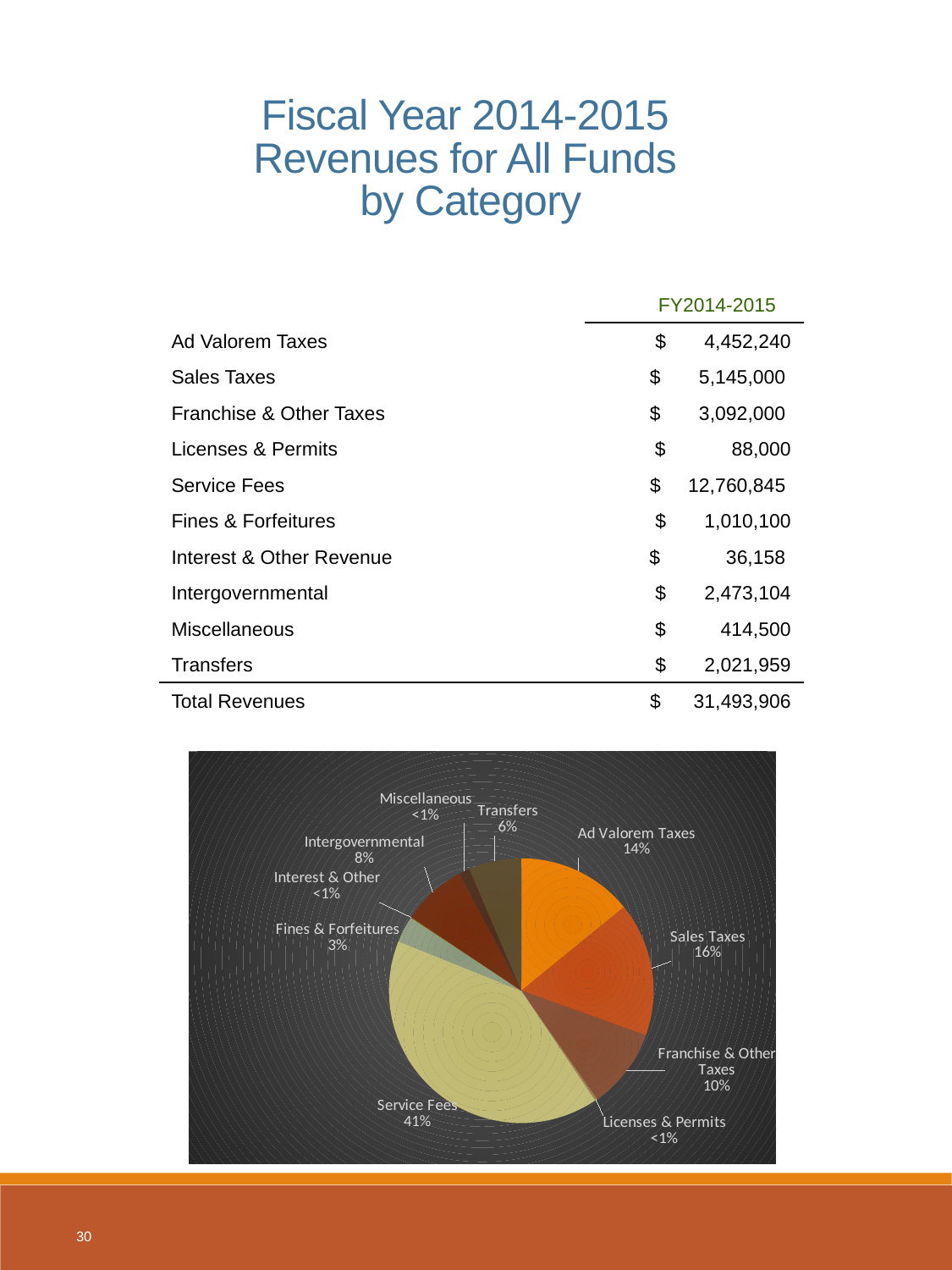
What share of the pie does Transfers represent? 6% What share of the pie does Fines & Forfeitures represent? 3% What share of the pie does Service Fees represent? 41% What kind of chart is shown on the slide? pie chart Which slice is larger, Intergovernmental or Transfers? Intergovernmental How many slices does the pie chart have? 10 By how many percentage points does the Sales Taxes share exceed the Ad Valorem Taxes share? 2 Which category has the largest slice of the pie? Service Fees